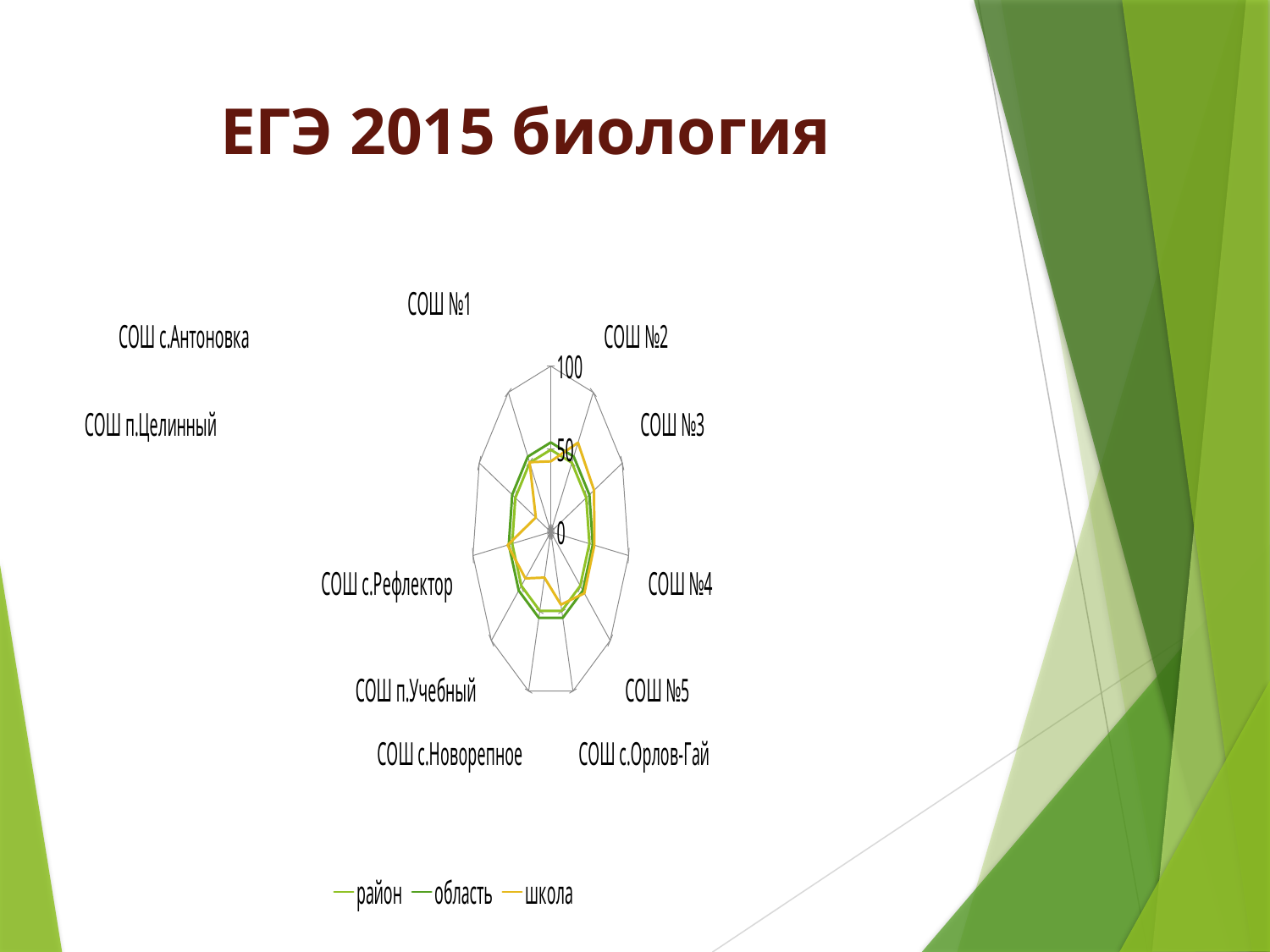
Is the value of the школа series for СОШ №4 greater or less than 100? less Is the value of the школа series for СОШ с.Рефлектор greater or less than 100? less What is the title of the slide containing the chart? ЕГЭ 2015 биология What is the highest value shown on the chart's radial axis? 100 How many series does the legend list? 3 Is the value of the район series for СОШ №5 greater or less than 100? less What kind of chart is shown on the slide? radar chart Which series is drawn in yellow in the chart? школа